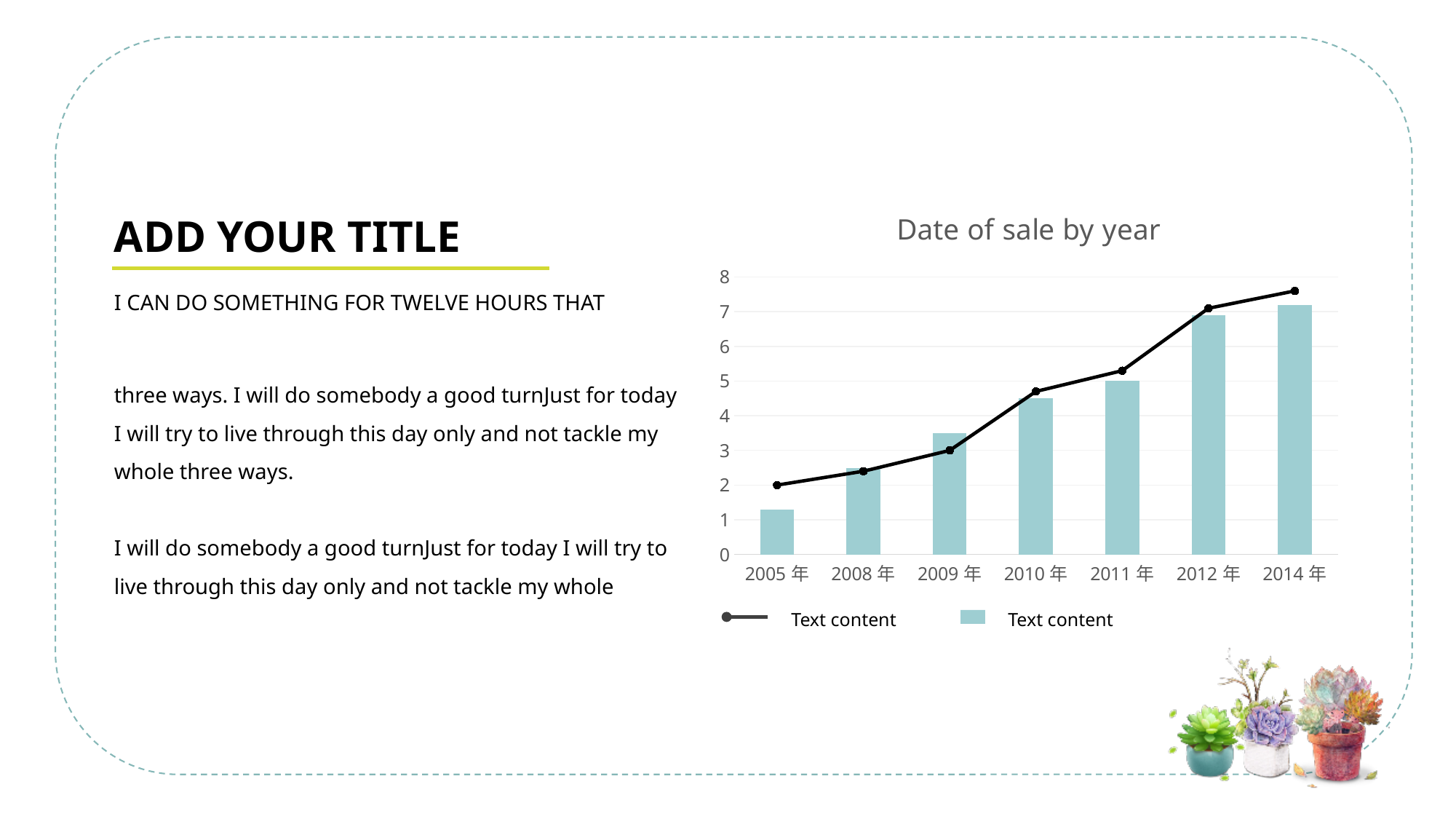
Do the bar values rise or fall from 2005 年 to 2014 年? Rise Which year has the shortest bar in the chart? 2005 年 Is the line value for 2014 年 greater or less than 7? greater How many series does the chart's legend list? 2 What colour are the bars in the chart? Light blue How many year categories are shown on the x axis of the chart? 7 Is the bar value for 2012 年 greater or less than 6? greater Which has the taller bar, 2010 年 or 2012 年? 2012 年 Is the bar value for 2005 年 greater or less than 2? less Which year has the tallest bar in the chart? 2014 年 What kind of chart is shown on the slide? Combined bar and line chart What is the title of the chart? Date of sale by year